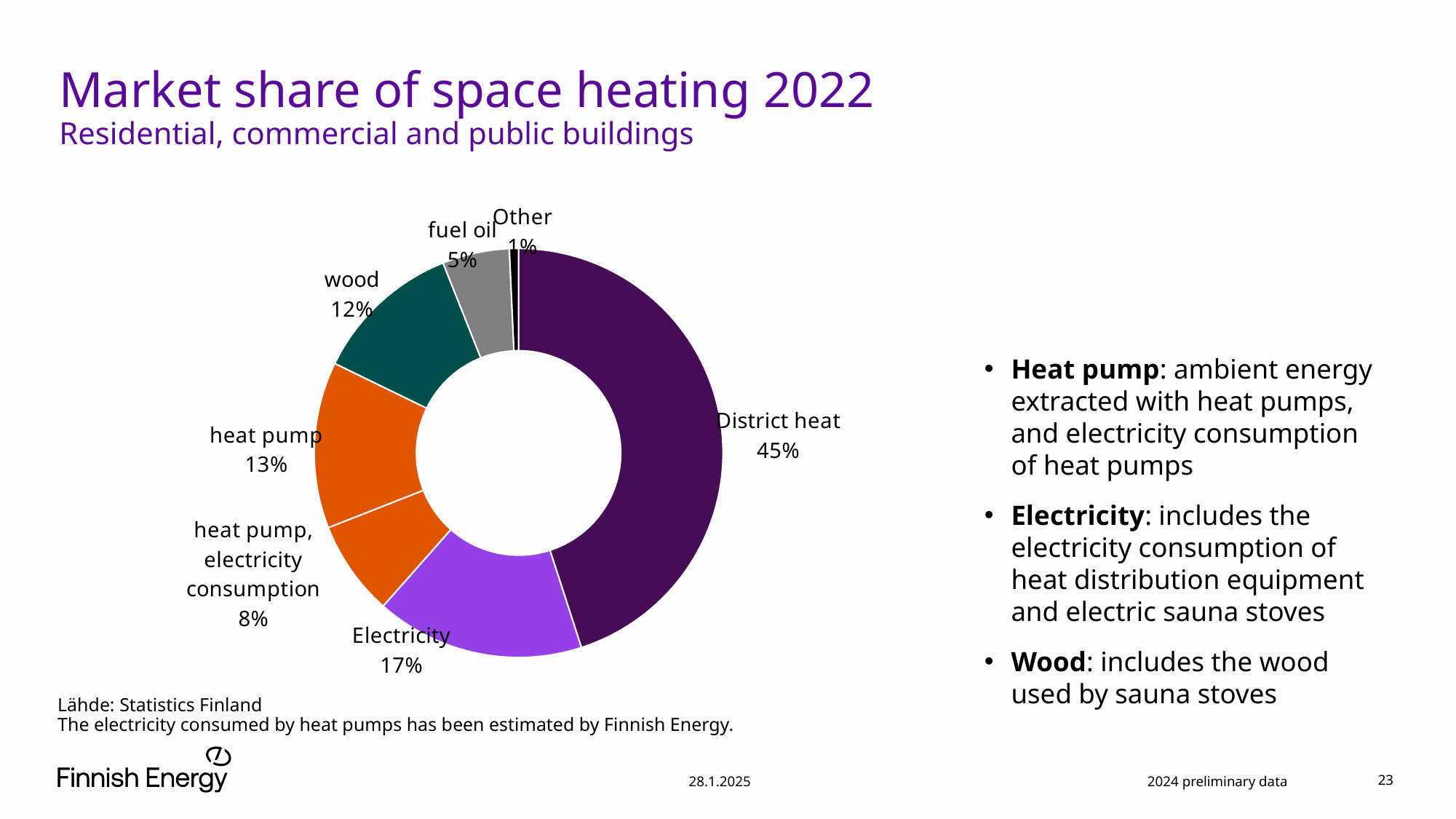
What is the share shown for heat pump, electricity consumption? 8% What is the share shown for wood? 12% Which has a larger share, heat pump or wood? heat pump What share of space heating does Electricity hold? 17% How many categories are shown in the donut chart? 7 How many percentage points larger is the District heat share than the Electricity share? 28 What is the title of the chart slide? Market share of space heating 2022 What is the share shown for fuel oil? 5% Which category has the largest share of space heating? District heat What is the market share of District heat in the space heating chart? 45% Which category has the smallest share of space heating? Other What type of chart is used to show the market share of space heating? Donut (pie) chart